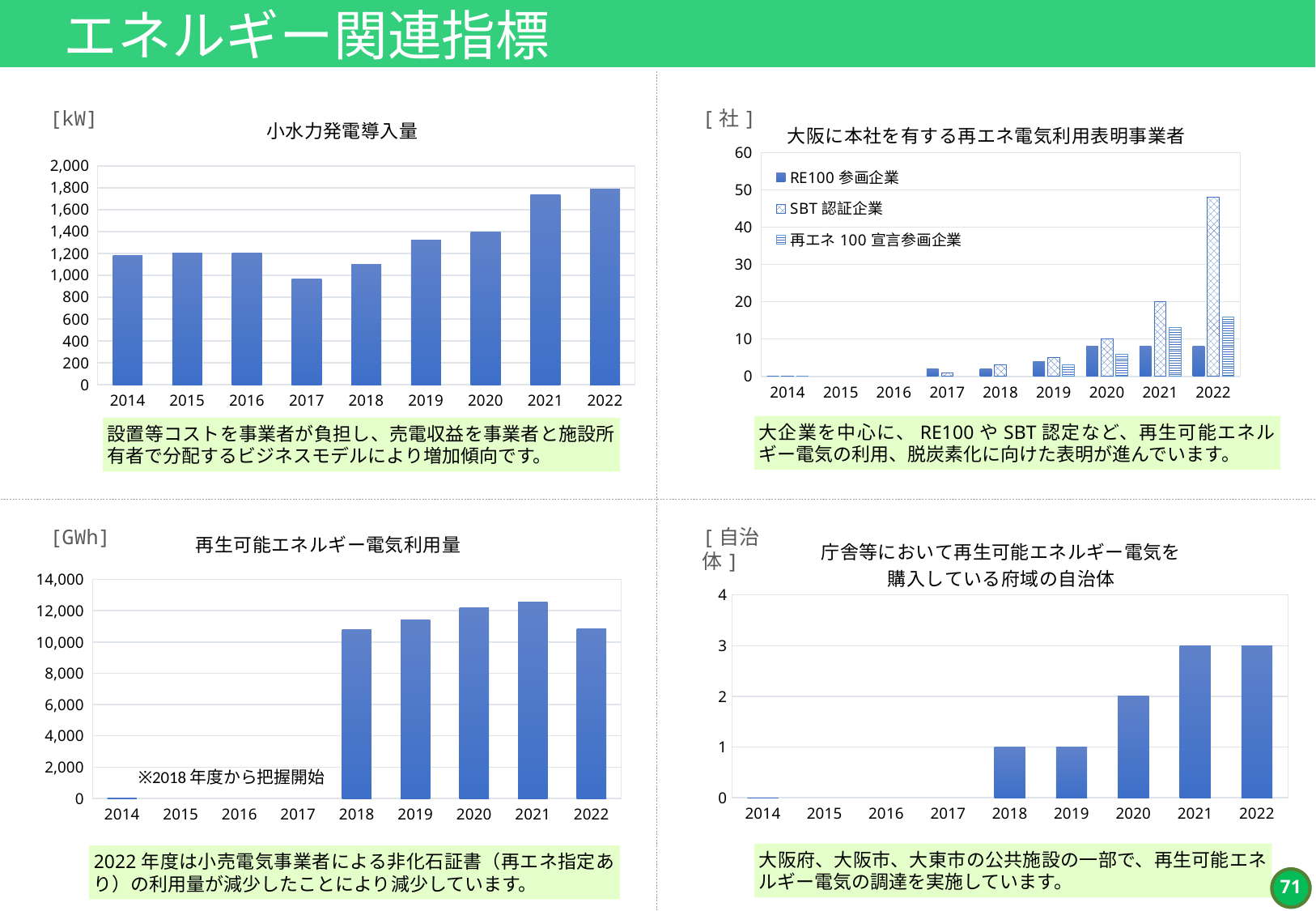
In the 庁舎等において再生可能エネルギー電気を購入している府域の自治体 chart (bottom right), what is the difference between the values for 2021 and 2020? 1 In the 大阪に本社を有する再エネ電気利用表明事業者 chart (top right), how many series does the legend list? 3 In the 庁舎等において再生可能エネルギー電気を購入している府域の自治体 chart (bottom right), what is the value for 2020? 2 In the 小水力発電導入量 chart (top left), is the value for 2021 greater or less than 1,600? greater In the 小水力発電導入量 chart (top left), which year has the lowest value? 2017 In the 大阪に本社を有する再エネ電気利用表明事業者 chart (top right), is the value for SBT 認証企業 in 2022 greater or less than 40? greater What kind of chart is the 再生可能エネルギー電気利用量 chart (bottom left)? bar chart In the 再生可能エネルギー電気利用量 chart (bottom left), is the value for 2022 greater or less than 12,000? less In the 再生可能エネルギー電気利用量 chart (bottom left), which year has the highest value? 2021 In the 小水力発電導入量 chart (top left), how many years are shown on the x axis? 9 In the 庁舎等において再生可能エネルギー電気を購入している府域の自治体 chart (bottom right), which is larger, the value for 2019 or the value for 2021? 2021